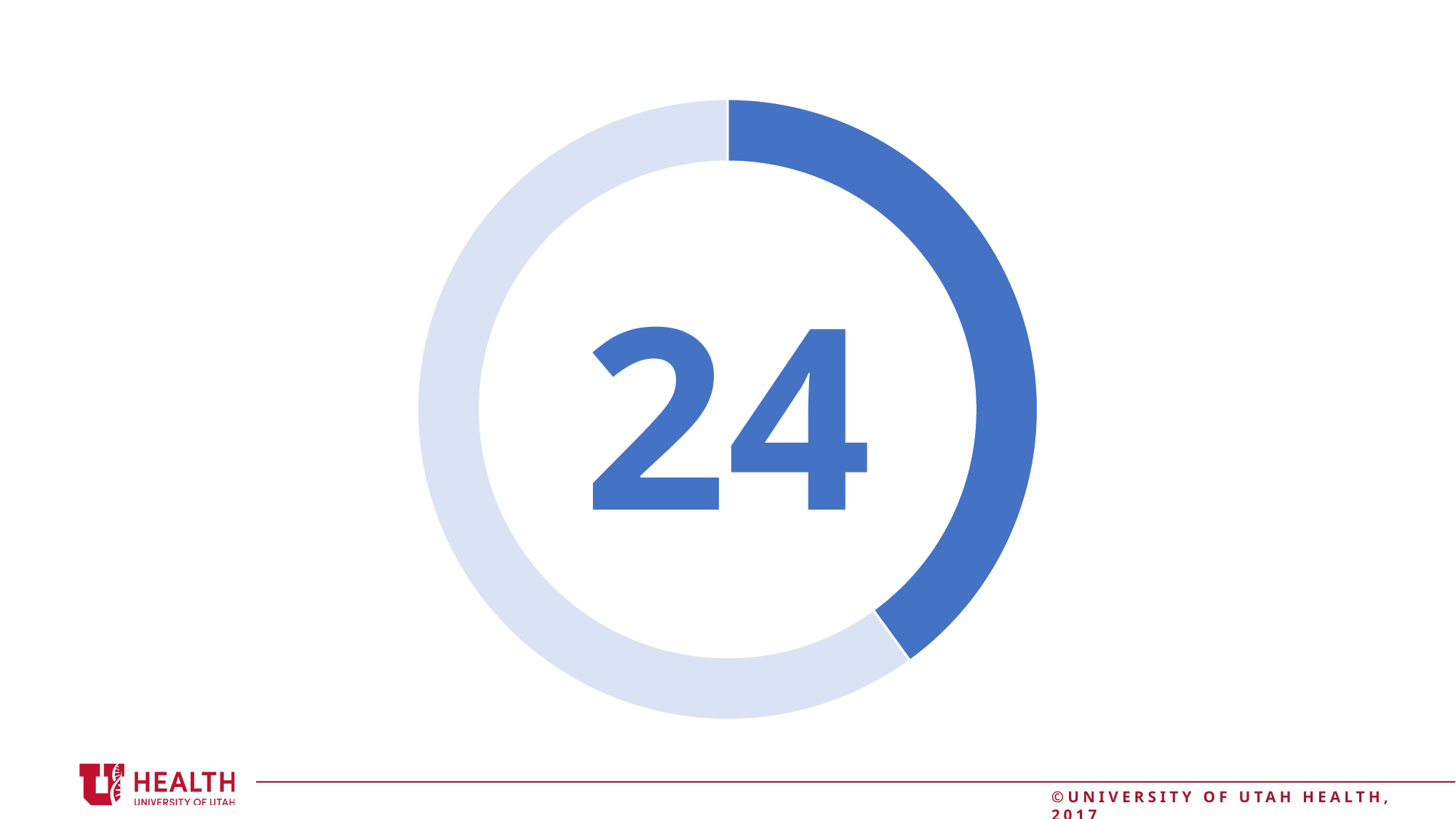
Does the donut chart have a legend? No What kind of chart is shown on the slide? Donut chart How many segments does the donut chart have? 2 Which segment of the donut chart is larger, the dark blue one or the light blue one? The light blue one What number is displayed in the center of the donut chart? 24 Does the dark blue segment cover more or less than half of the ring? less